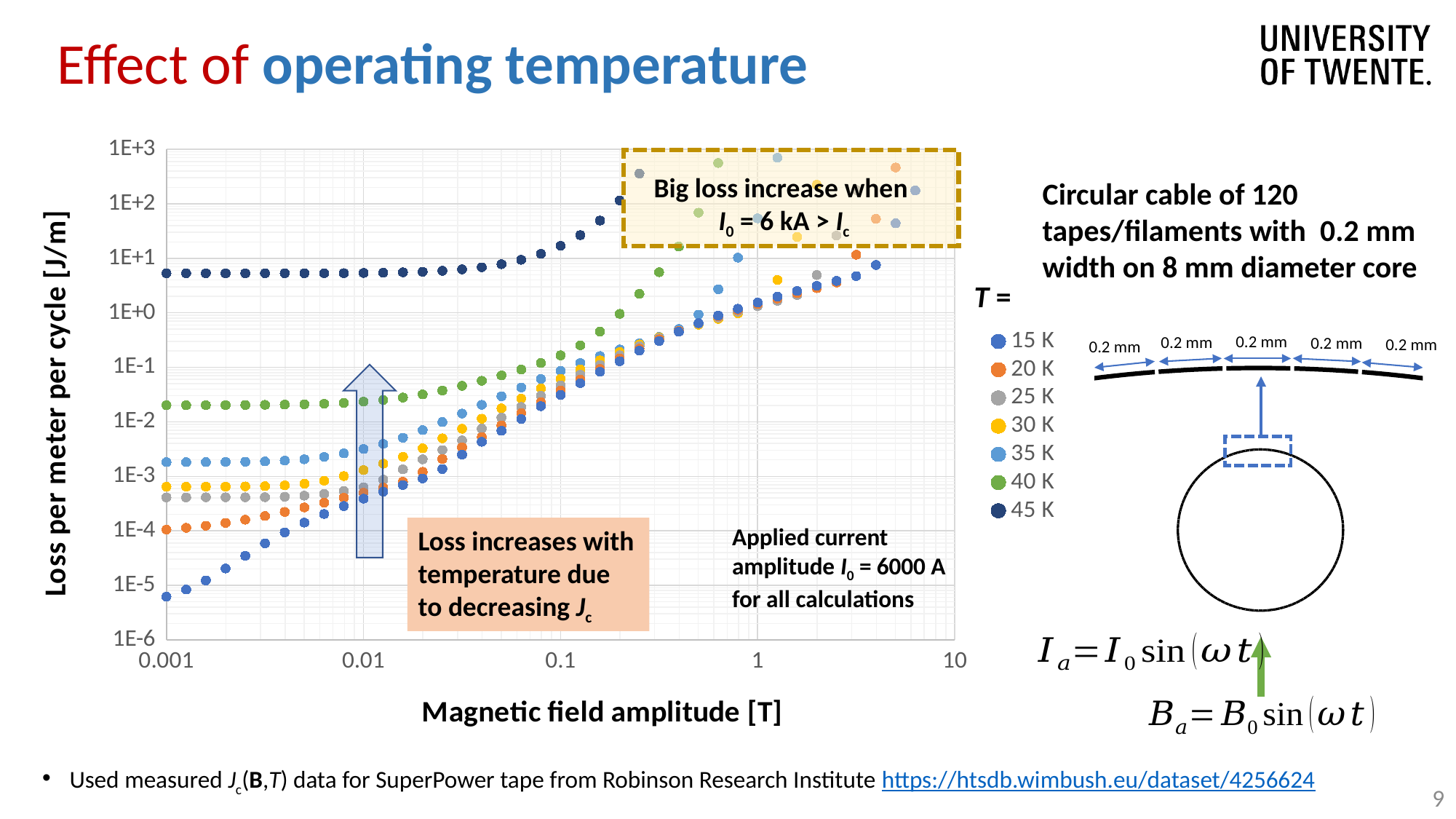
What kind of chart is shown on the slide? scatter chart At 0.001 T, which series has the larger loss, 40 K or 30 K? 40 K What is the label of the x axis of the chart? Magnetic field amplitude [T] At 0.001 T, is the loss for the 35 K series greater or less than 1E-3 J/m? greater Which series has the lowest loss at a magnetic field amplitude of 0.001 T? 15 K Which series has the highest loss at a magnetic field amplitude of 0.001 T? 45 K At 0.001 T, is the loss for the 40 K series greater or less than 1E-2 J/m? greater What is the label of the y axis of the chart? Loss per meter per cycle [J/m] How many series does the chart legend list? 7 At 0.001 T, is the loss for the 15 K series greater or less than 1E-5 J/m? less Does the loss for the 15 K series rise or fall as the magnetic field amplitude increases? rise